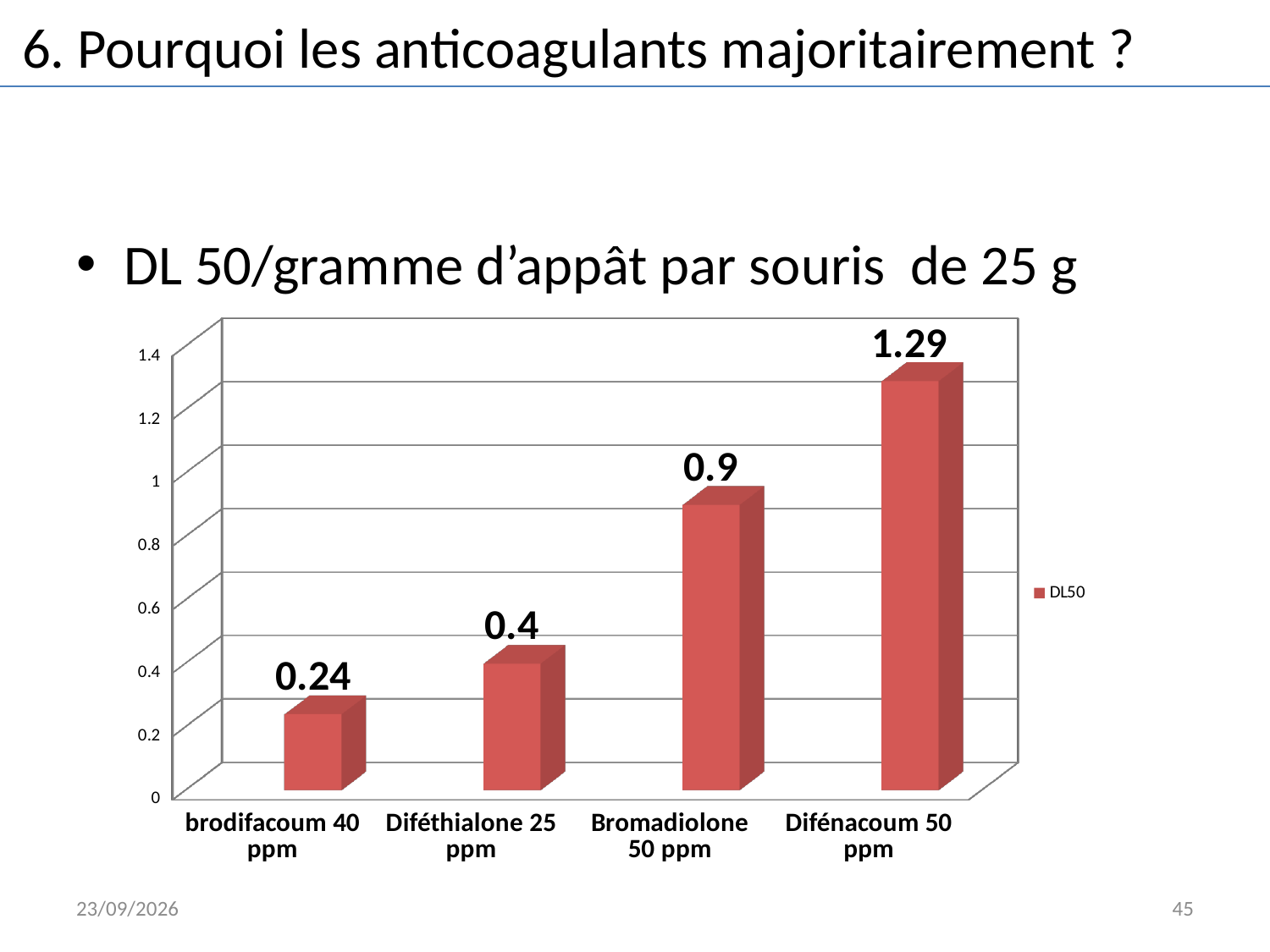
What is the DL50 value for Bromadiolone 50 ppm? 0.9 What kind of chart is shown on the slide? bar chart How many series does the chart legend list? 1 What is the DL50 value for Diféthialone 25 ppm? 0.4 What is the DL50 value for Difénacoum 50 ppm? 1.29 Which category has the highest DL50 value? Difénacoum 50 ppm How many categories are shown on the x axis of the chart? 4 What is the DL50 value for brodifacoum 40 ppm? 0.24 Is the DL50 value for Difénacoum 50 ppm greater or less than 1.2? greater What is the difference between the DL50 values for Difénacoum 50 ppm and Bromadiolone 50 ppm? 0.39 Which has a larger DL50 value, Diféthialone 25 ppm or Bromadiolone 50 ppm? Bromadiolone 50 ppm Which category has the lowest DL50 value? brodifacoum 40 ppm